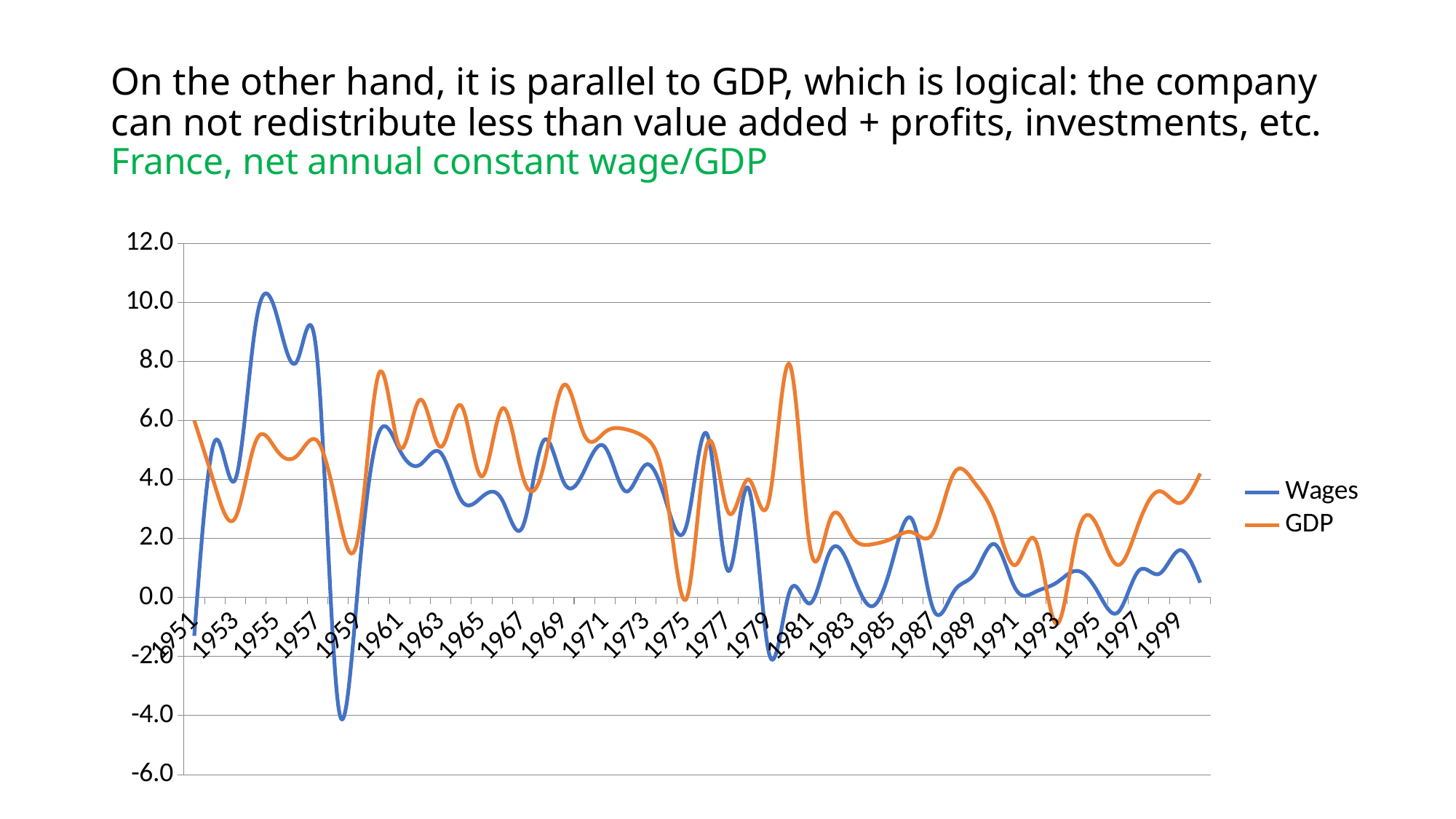
Is the value for Wages in 1955 greater or less than 8.0? greater In 1955, which series has the higher value, Wages or GDP? Wages What is the green chart title shown on the slide? France, net annual constant wage/GDP In which year does the Wages series reach its lowest value? 1958 Is the value for Wages in 1959 greater or less than -2.0? greater What kind of chart is shown on the slide? line chart Is the value for GDP in 1975 greater or less than 2.0? less In which year does the Wages series reach its highest value? 1955 What are the two series named in the legend? Wages and GDP In 1989, which series has the higher value, Wages or GDP? GDP How many series does the legend list? 2